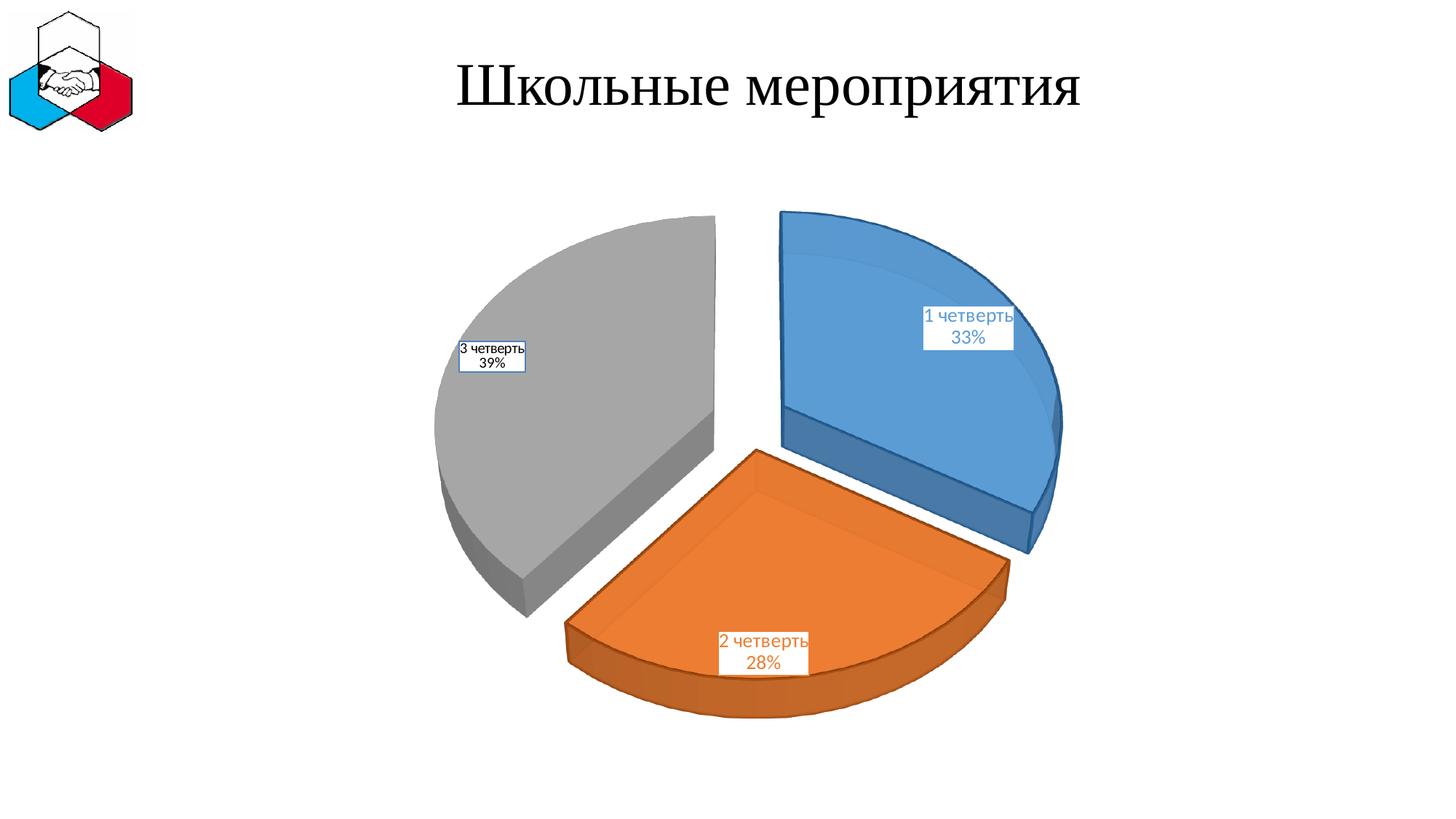
What is the difference in percentage points between 3 четверть and 2 четверть? 11 What is the difference in percentage points between 1 четверть and 2 четверть? 5 What share of the pie does 2 четверть have? 28% Which slice is the smallest? 2 четверть What kind of chart is shown on the slide? pie chart What share of the pie does 1 четверть have? 33% Which is larger, 1 четверть or 3 четверть? 3 четверть What colour is the slice for 2 четверть? orange Which slice is the largest? 3 четверть How many slices does the pie chart have? 3 What is the title of the slide? Школьные мероприятия What share of the pie does 3 четверть have? 39%